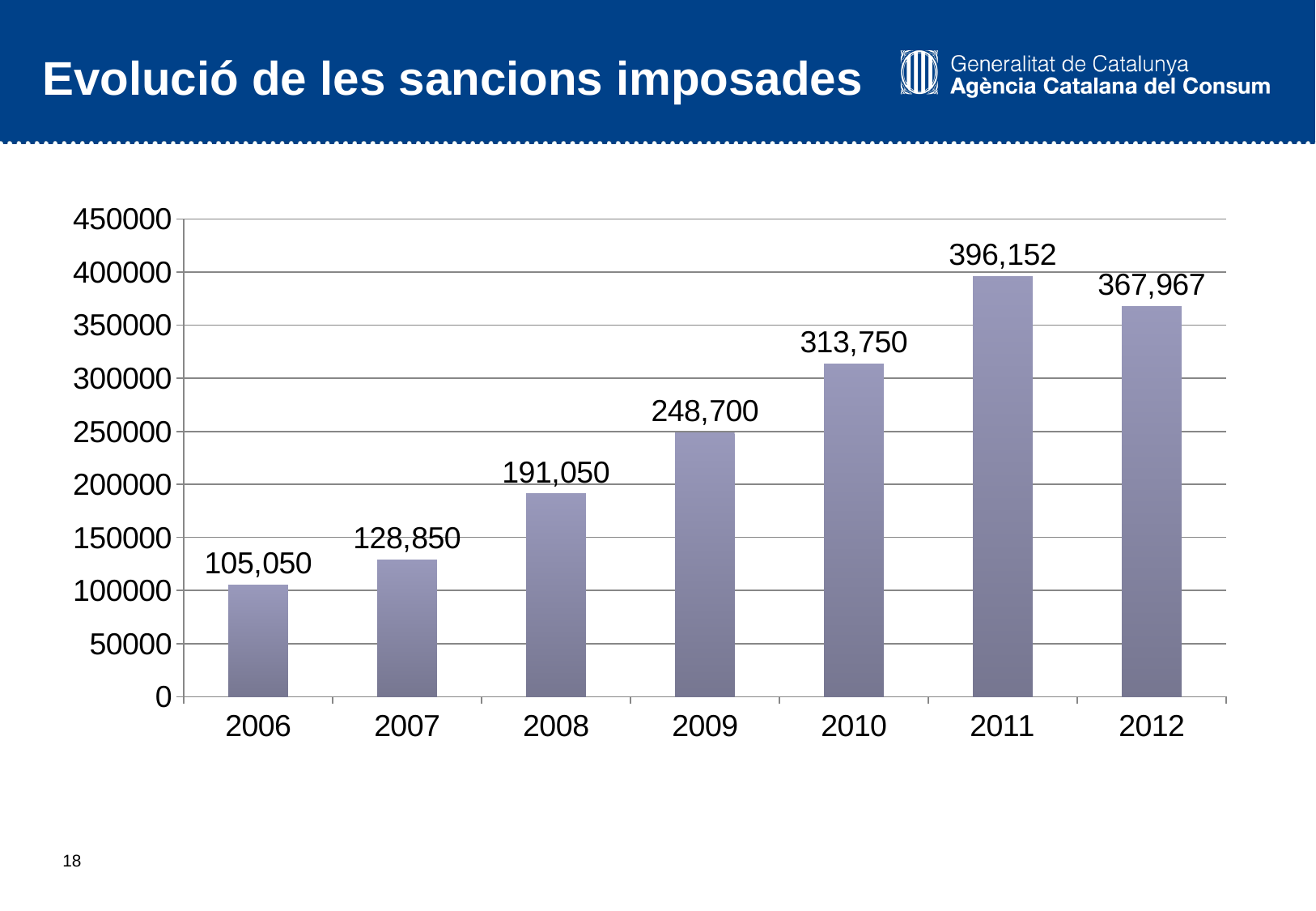
What is the difference between the values for 2007 and 2006? 23,800 What is the value for 2006? 105,050 What is the value for 2012? 367,967 What is the value for 2009? 248,700 Do the values rise or fall from 2006 to 2011? rise Which is larger, the value for 2010 or the value for 2009? 2010 How many years are shown on the x axis? 7 What is the difference between the values for 2011 and 2012? 28,185 Which year has the highest value? 2011 What kind of chart is shown on the slide? bar chart Is the value for 2008 greater or less than 200000? less Which year has the lowest value? 2006